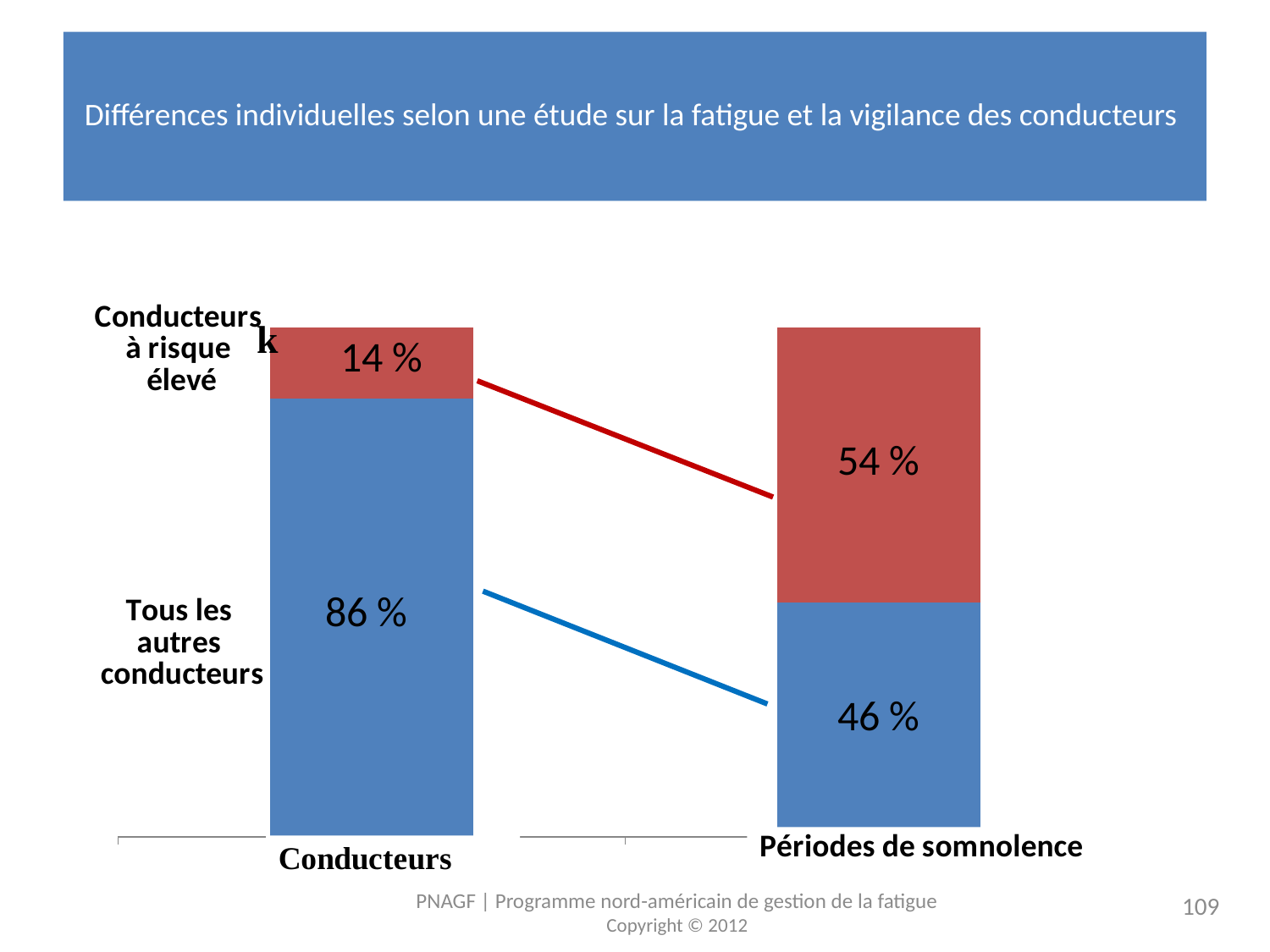
What is the difference between the two segments of the "Conducteurs" bar? 72 % In the "Périodes de somnolence" bar, which segment is larger: "Conducteurs à risque élevé" or "Tous les autres conducteurs"? Conducteurs à risque élevé How many series are shown in the stacked bars? 2 Does the "Conducteurs à risque élevé" share rise or fall from the "Conducteurs" bar to the "Périodes de somnolence" bar? Rise What value is shown for "Conducteurs à risque élevé" in the "Périodes de somnolence" bar? 54 % What share of the "Conducteurs" bar is labelled for "Tous les autres conducteurs"? 86 % Which colour represents "Conducteurs à risque élevé" in the chart? Red What value is shown for "Tous les autres conducteurs" in the "Périodes de somnolence" bar? 46 % What kind of chart is shown on the slide? Stacked bar chart How many bars (categories) are plotted in the chart? 2 What is the difference between the "Conducteurs à risque élevé" share in the "Périodes de somnolence" bar and in the "Conducteurs" bar? 40 % What share of the "Conducteurs" bar is labelled for "Conducteurs à risque élevé"? 14 %